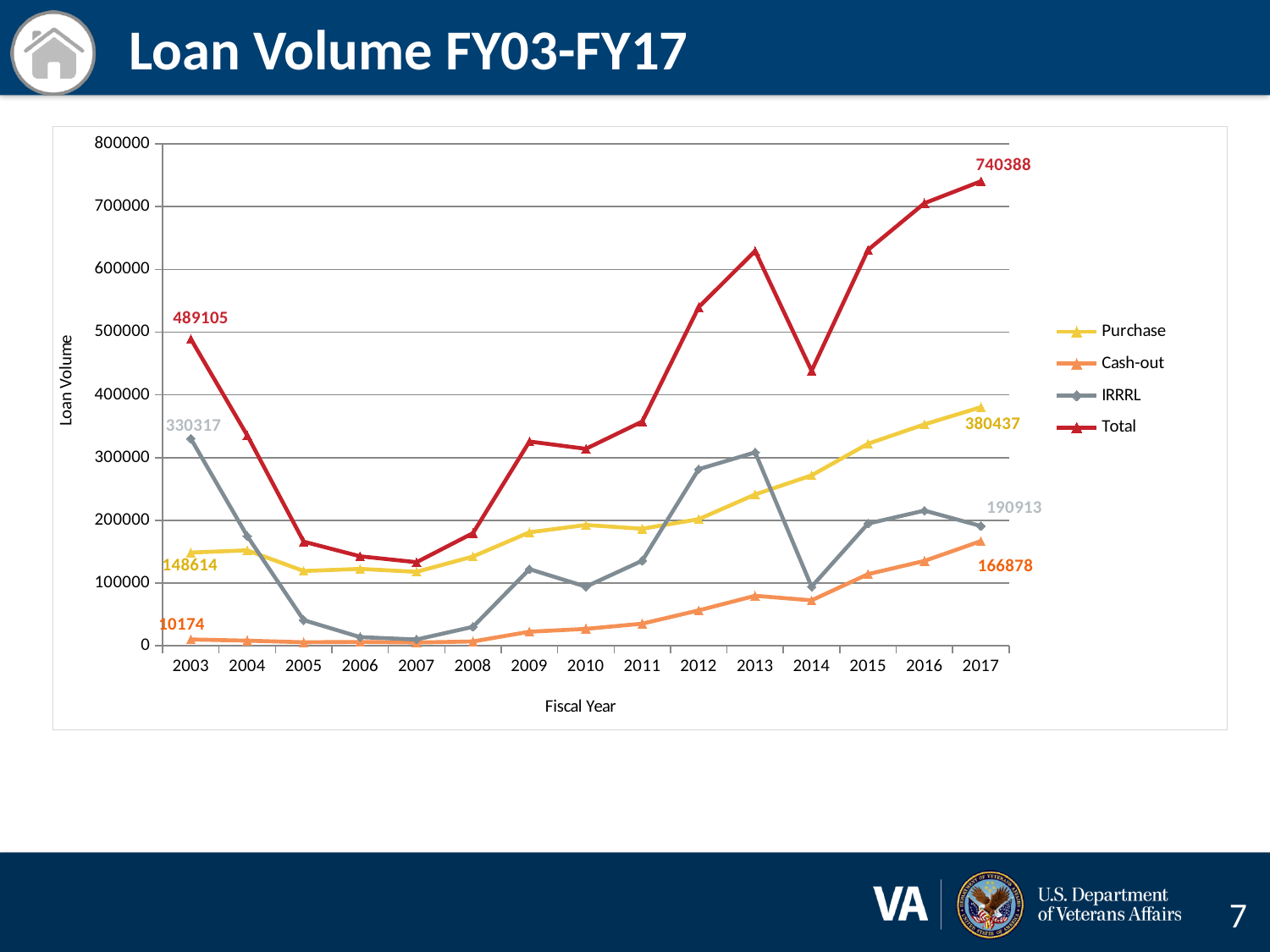
By how much did the Total loan volume increase from 2003 to 2017? 251283 What is the difference between the Purchase loan volume in 2017 and in 2003? 231823 What is the Cash-out loan volume in 2017? 166878 Is the Purchase loan volume in 2015 greater or less than 300000? greater What is the IRRRL loan volume in 2003? 330317 What type of chart is shown on the slide? Line chart How many series does the legend list? 4 What is the value of the Total series in 2017? 740388 Which is larger, the IRRRL loan volume in 2003 or in 2017? 2003 What is the Purchase loan volume in 2003? 148614 How many fiscal years are shown on the x axis? 15 Is the Total loan volume in 2014 greater or less than 500000? less